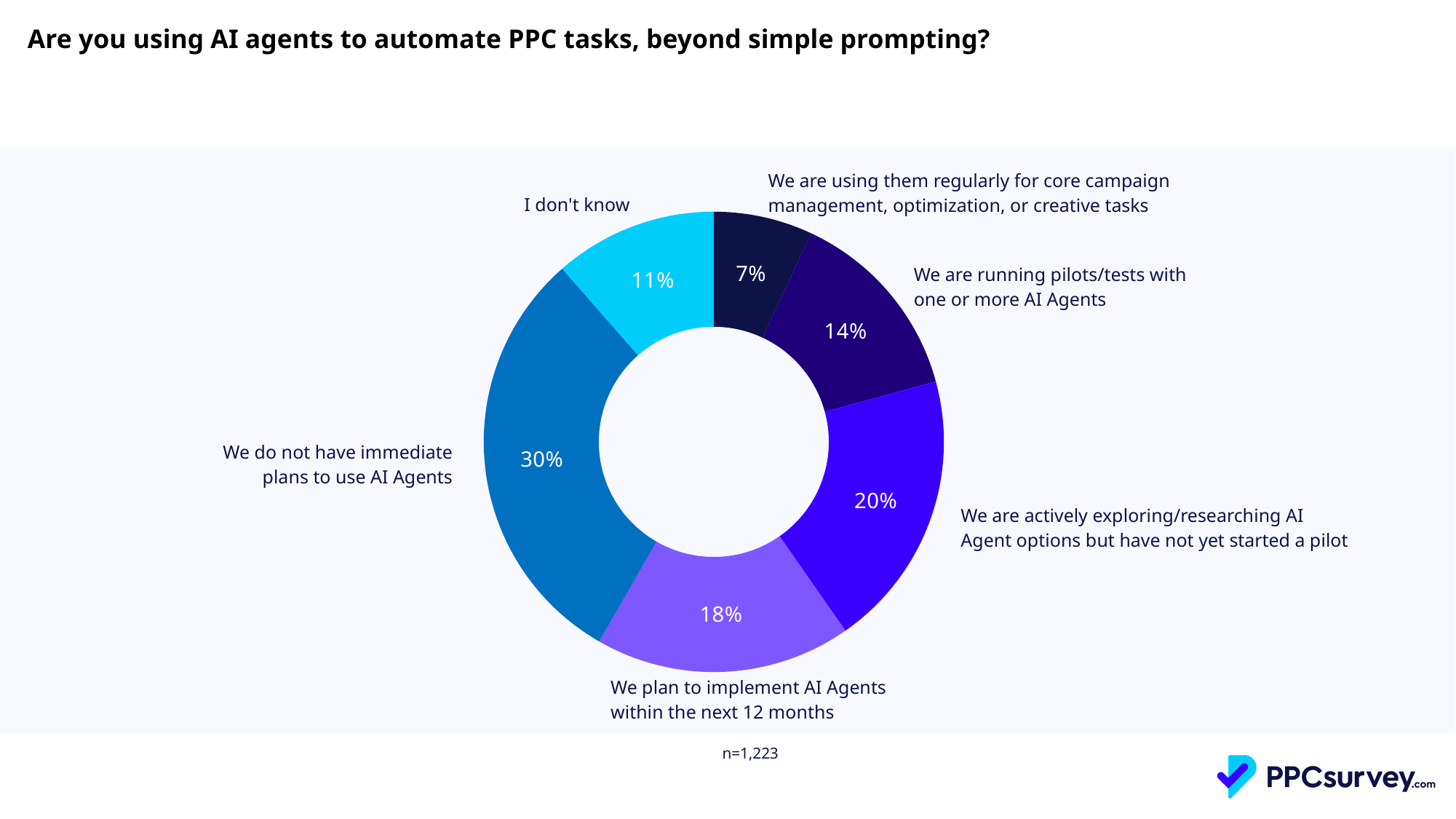
Which response has the smallest share of the chart? We are using them regularly for core campaign management, optimization, or creative tasks What share of respondents are using AI agents regularly for core campaign management, optimization, or creative tasks? 7% What is the combined share of respondents who are either using AI agents regularly or running pilots/tests? 21% What is the sample size (n) shown below the chart? n=1,223 What type of chart is shown on the slide? Donut (pie) chart How many response categories are shown in the chart? 6 What percentage of respondents said they do not have immediate plans to use AI Agents? 30% Which is larger: the share running pilots/tests with AI Agents or the share that answered 'I don't know'? We are running pilots/tests with one or more AI Agents Which response has the largest share of the chart? We do not have immediate plans to use AI Agents What is the difference in percentage points between those actively exploring/researching AI Agent options and those planning to implement AI Agents within the next 12 months? 2 percentage points What percentage of respondents answered 'I don't know'? 11% What percentage of respondents are running pilots/tests with one or more AI Agents? 14%